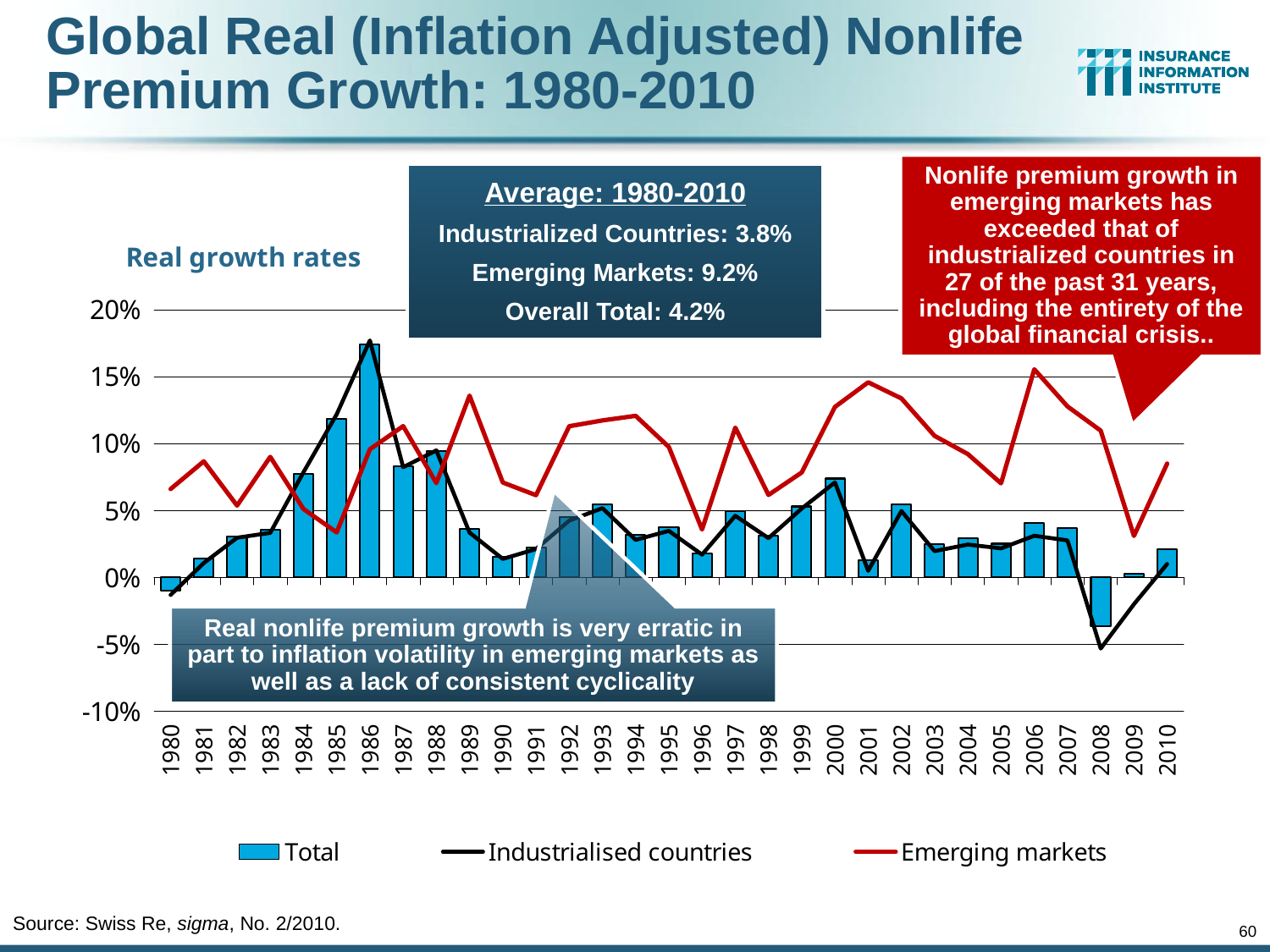
Is the Total value for 1986 greater or less than 15%? greater How many series does the legend list? 3 Do the Total bars rise or fall from 1983 to 1986? rise In which year is the Total bar the highest? 1986 In 2000, which is higher: Emerging markets or Industrialised countries? Emerging markets Is the Emerging markets value for 1996 greater or less than 5%? less In which year is the Total bar the lowest? 2008 Is the Total value for 2008 greater or less than 0%? less How many years are shown along the x axis? 31 Which series is drawn as a red line in the legend? Emerging markets What kind of chart is shown on the slide? A combination bar and line chart In 1985, which is higher: Industrialised countries or Emerging markets? Industrialised countries